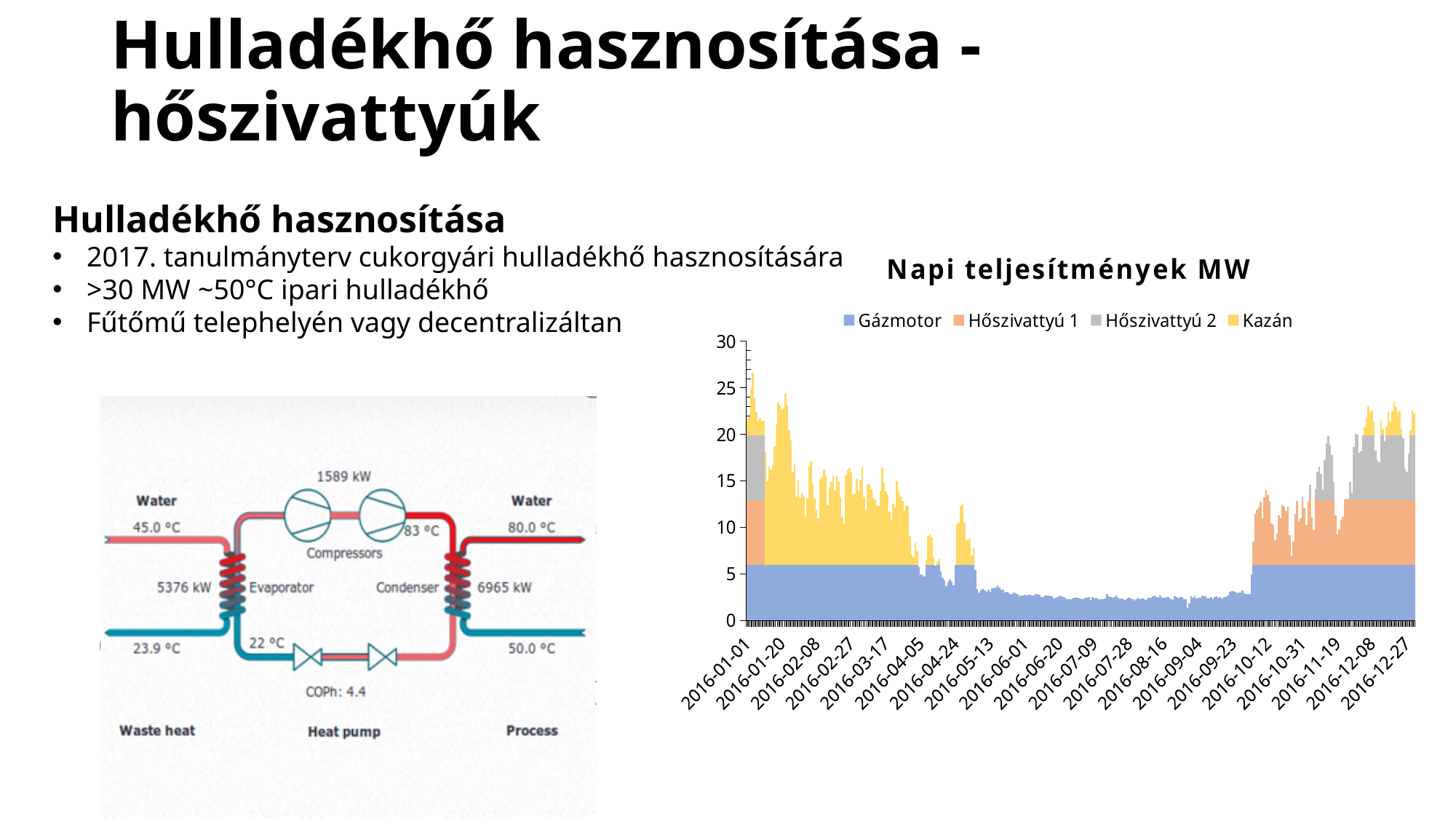
What kind of chart is shown on the slide? stacked bar chart Is the total value at 2016-01-01 greater or less than 20? greater Is the total value around 2016-07-09 greater or less than 5? less What is the title of the chart on the slide? Napi teljesítmények MW Do the total values rise or fall from 2016-01-01 to 2016-07-09? fall Is the Gázmotor value around 2016-08-16 greater or less than 5? less Which series forms the bottom layer of the stack in the chart? Gázmotor What is the highest value shown on the y axis of the chart? 30 Do the total values rise or fall from 2016-09-23 to 2016-12-27? rise How many series does the legend of the chart list? 4